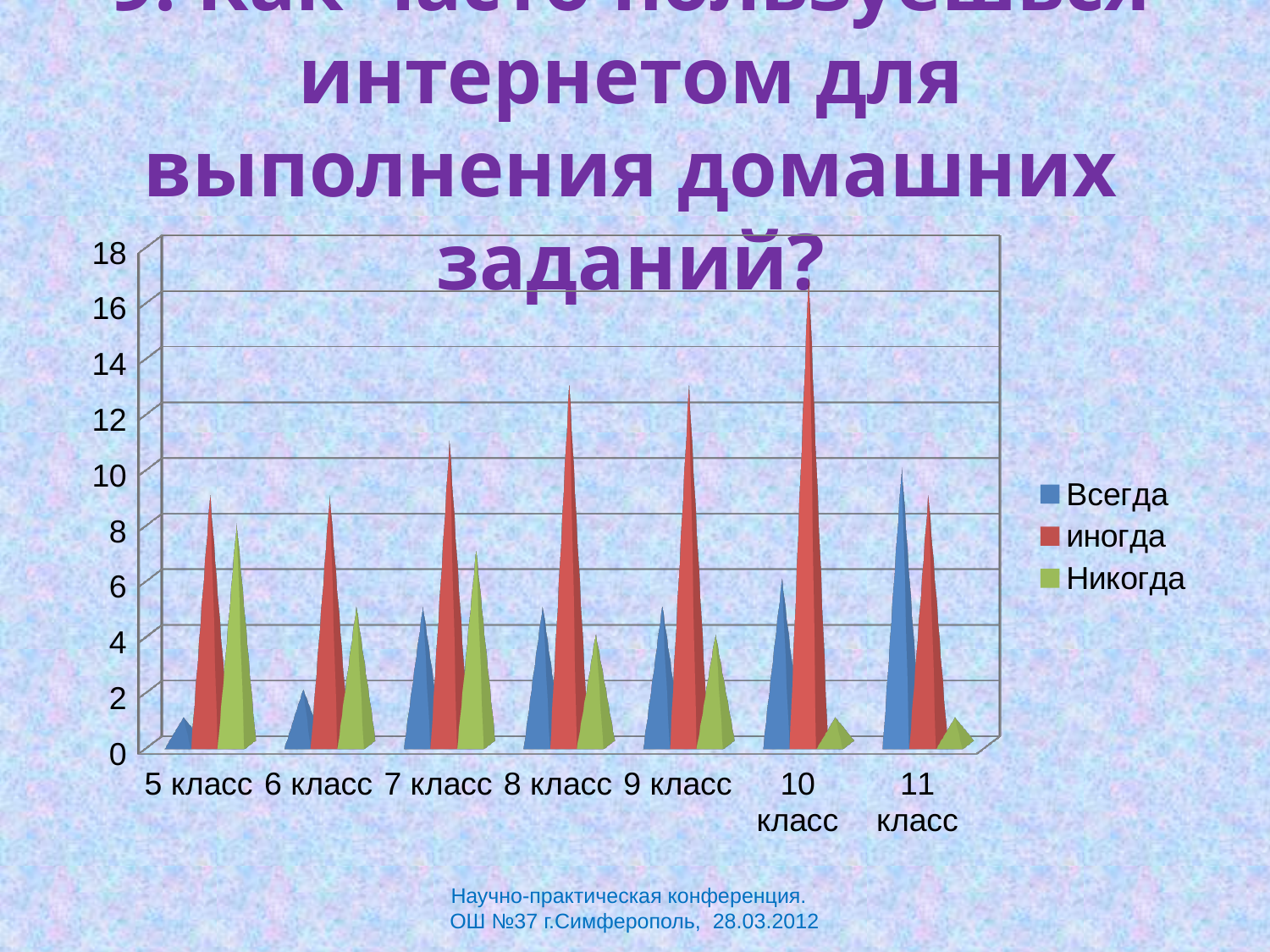
How many series does the legend list? 3 How many class categories are shown on the x axis? 7 Is the value of "иногда" for 10 класс greater or less than 14? greater Which class has the highest value for the series "иногда"? 10 класс What kind of chart is shown on the slide? bar chart Which colour represents the series "Никогда" in the legend? green Does the value of "Всегда" generally rise or fall from 5 класс to 11 класс? rise Which class has the lowest value for the series "Всегда"? 5 класс For 5 класс, which is larger: the value for "Всегда" or the value for "иногда"? иногда Is the value of "Всегда" for 11 класс greater or less than 8? greater Is the value of "Всегда" for 5 класс greater or less than 2? less